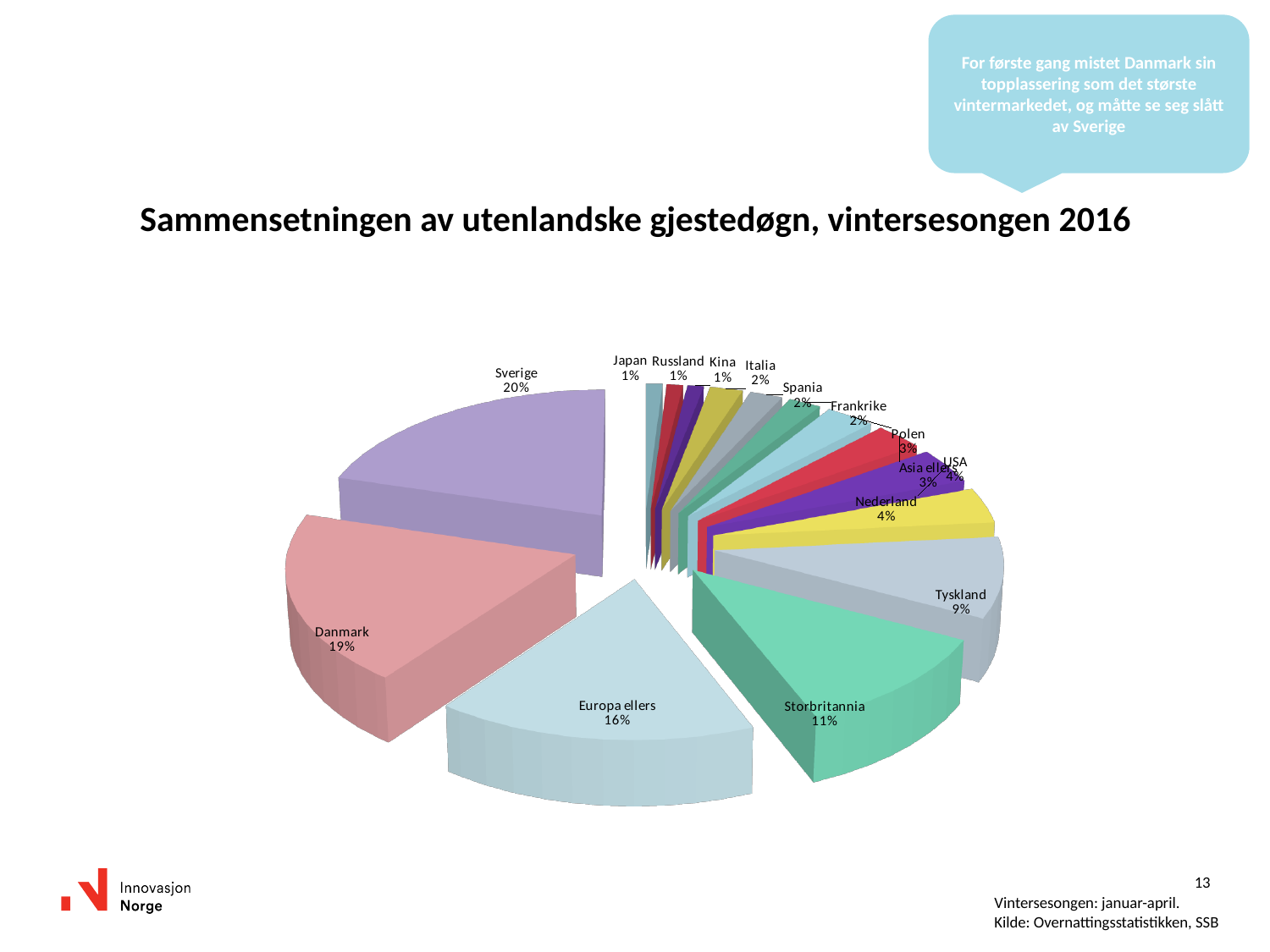
Which country has the largest slice in the pie chart? Sverige What percentage does the chart show for Tyskland? 9% How many slices does the pie chart contain? 15 What is the title of the chart? Sammensetningen av utenlandske gjestedøgn, vintersesongen 2016 What share of foreign guest nights does Sverige account for in the pie chart? 20% What is the difference in percentage points between Europa ellers and Storbritannia? 5 percentage points What share is shown for Europa ellers? 16% Which has the larger share, Tyskland or Storbritannia? Storbritannia What percentage is shown for Danmark in the pie chart? 19% What type of chart is shown on the slide? Pie chart How many percentage points larger is Sverige's share than Danmark's? 1 percentage point What share is labelled for Storbritannia? 11%